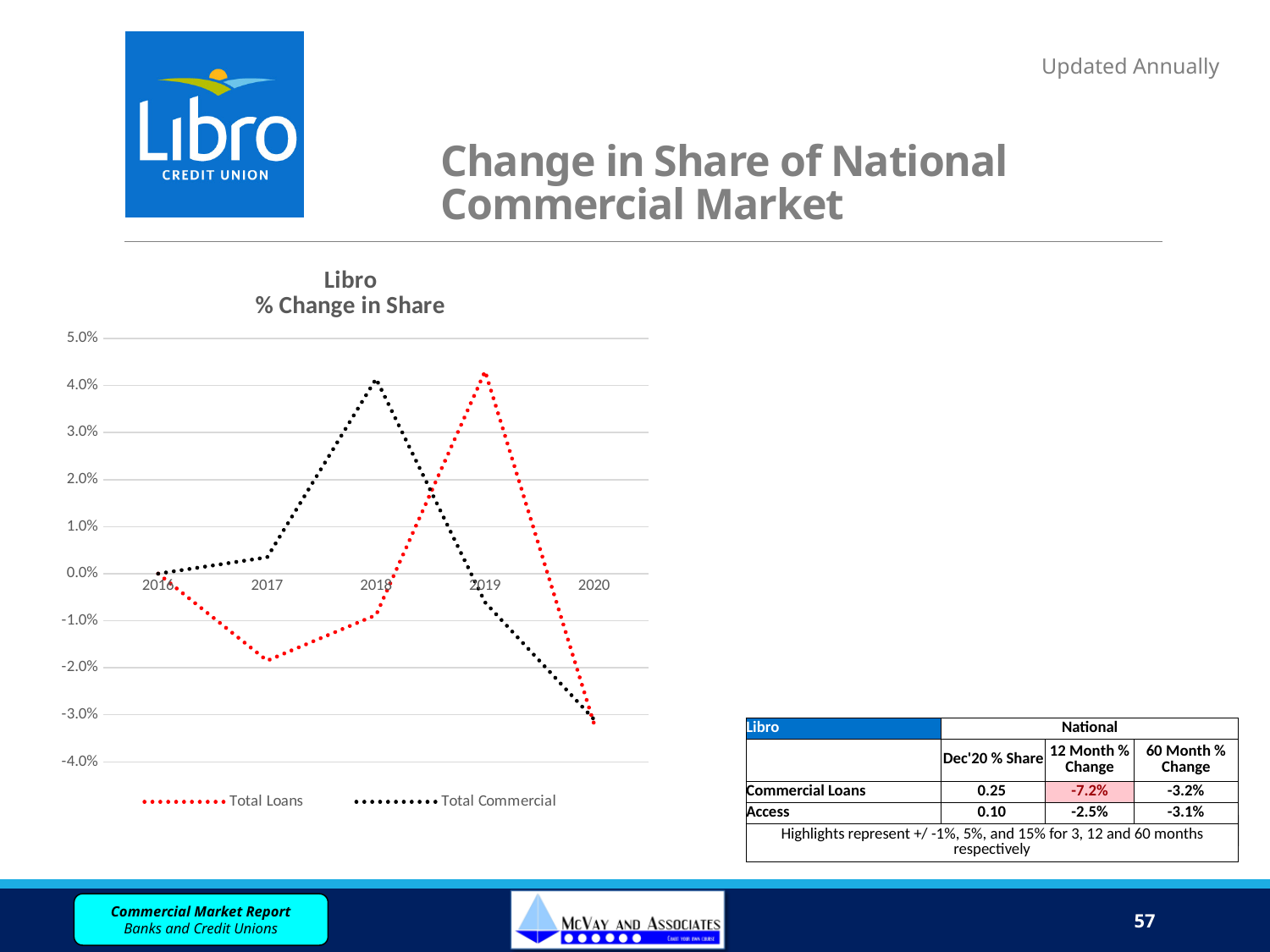
In which year does the Total Loans series reach its highest value? 2019 Is the value for Total Commercial in 2018 greater or less than 3.0%? greater In 2019, which series has the larger value, Total Loans or Total Commercial? Total Loans Does the Total Commercial series rise or fall from 2018 to 2020? fall Is the value for Total Commercial in 2020 greater or less than -2.0%? less How many years are shown on the x axis of the chart? 5 How many series does the chart legend list? 2 Is the value for Total Loans in 2017 greater or less than -1.0%? less In 2018, which series has the larger value, Total Loans or Total Commercial? Total Commercial What kind of chart is shown on the slide? line chart In which year does the Total Commercial series reach its lowest value? 2020 In which year does the Total Commercial series reach its highest value? 2018